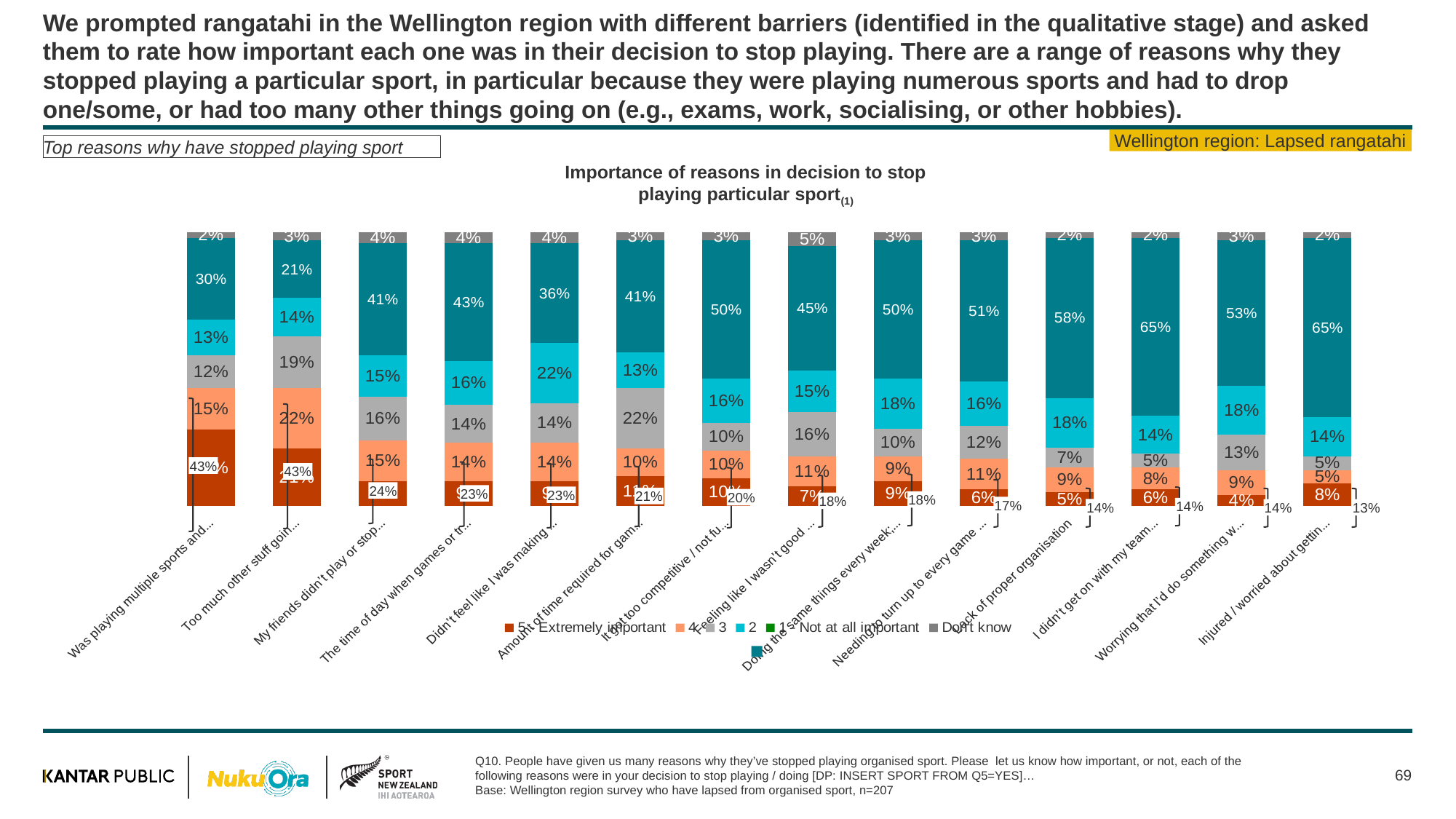
How many series does the legend list? 6 How many reasons (bars) are plotted in the chart? 14 What is the '1 - Not at all important' value for 'Was playing multiple sports and...'? 30% What kind of chart is shown on the slide? stacked bar chart Is the '1 - Not at all important' value for 'Injured / worried about gettin...' larger than that for 'Worrying that I'd do something w...'? Yes What is the '2' value for 'Didn't feel like I was making ...'? 22% Which reason has the highest '5 - Extremely important' share? Was playing multiple sports and... What is the 'Don't know' value for 'Feeling like I wasn't good ...'? 5% What is the difference between the '1 - Not at all important' values for 'Lack of proper organisation' and 'Was playing multiple sports and...'? 28% What is the '1 - Not at all important' value for 'Lack of proper organisation'? 58% Which reason has the lowest '1 - Not at all important' share? Too much other stuff goin... What is the title of the chart? Importance of reasons in decision to stop playing particular sport